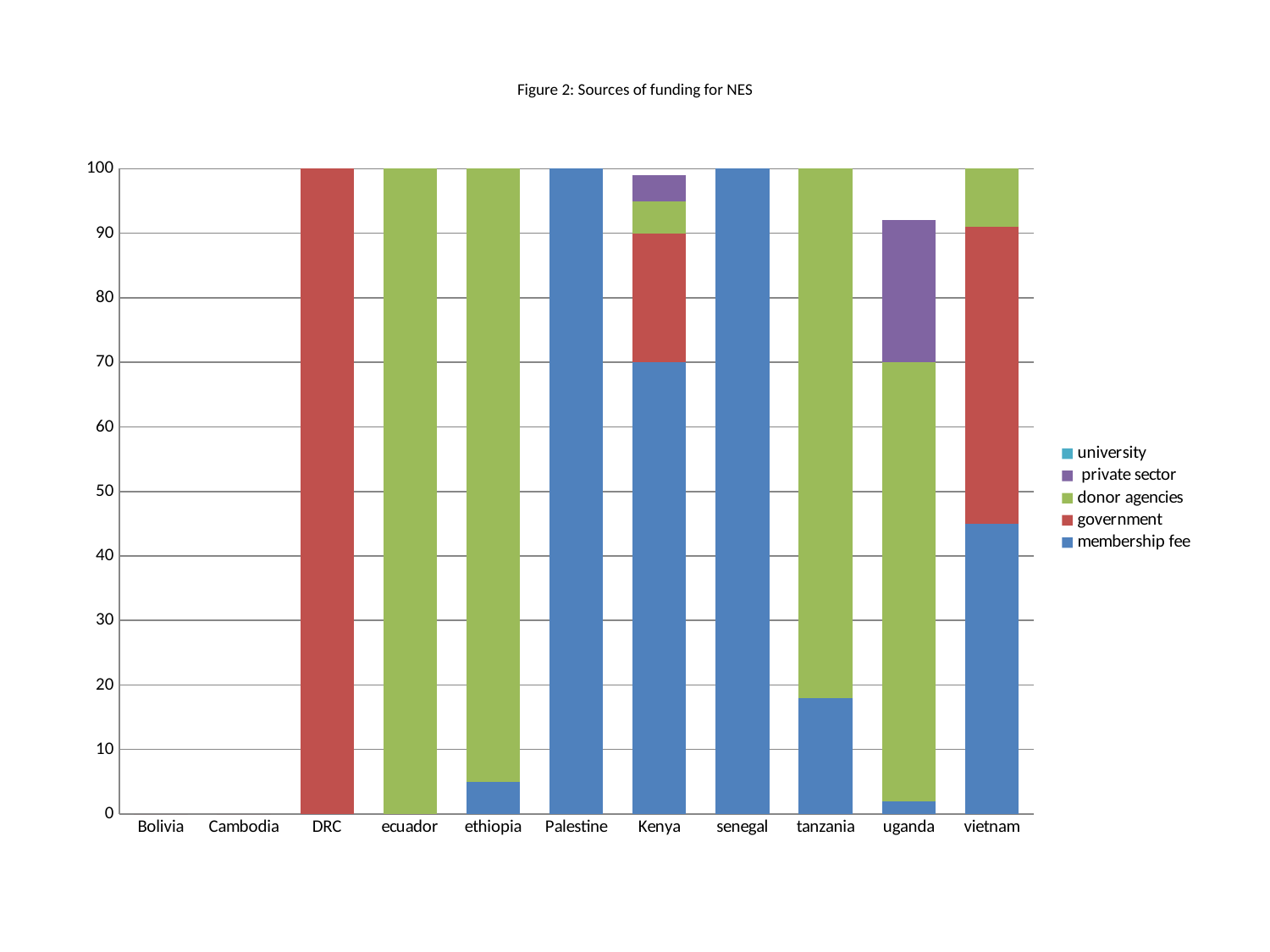
What is the government value for DRC? 100 What is the title of the chart? Figure 2: Sources of funding for NES Is the membership fee value for vietnam greater or less than 40? greater What is the membership fee value for Palestine? 100 Which country has the largest private sector segment? uganda Which is larger, the membership fee value for Kenya or for tanzania? Kenya Is the membership fee value for ethiopia greater or less than 10? less What type of chart is shown on the slide? stacked bar chart What is the membership fee value for Kenya? 70 How many countries are listed along the x axis? 11 What is the donor agencies value for ecuador? 100 How many series does the legend list? 5